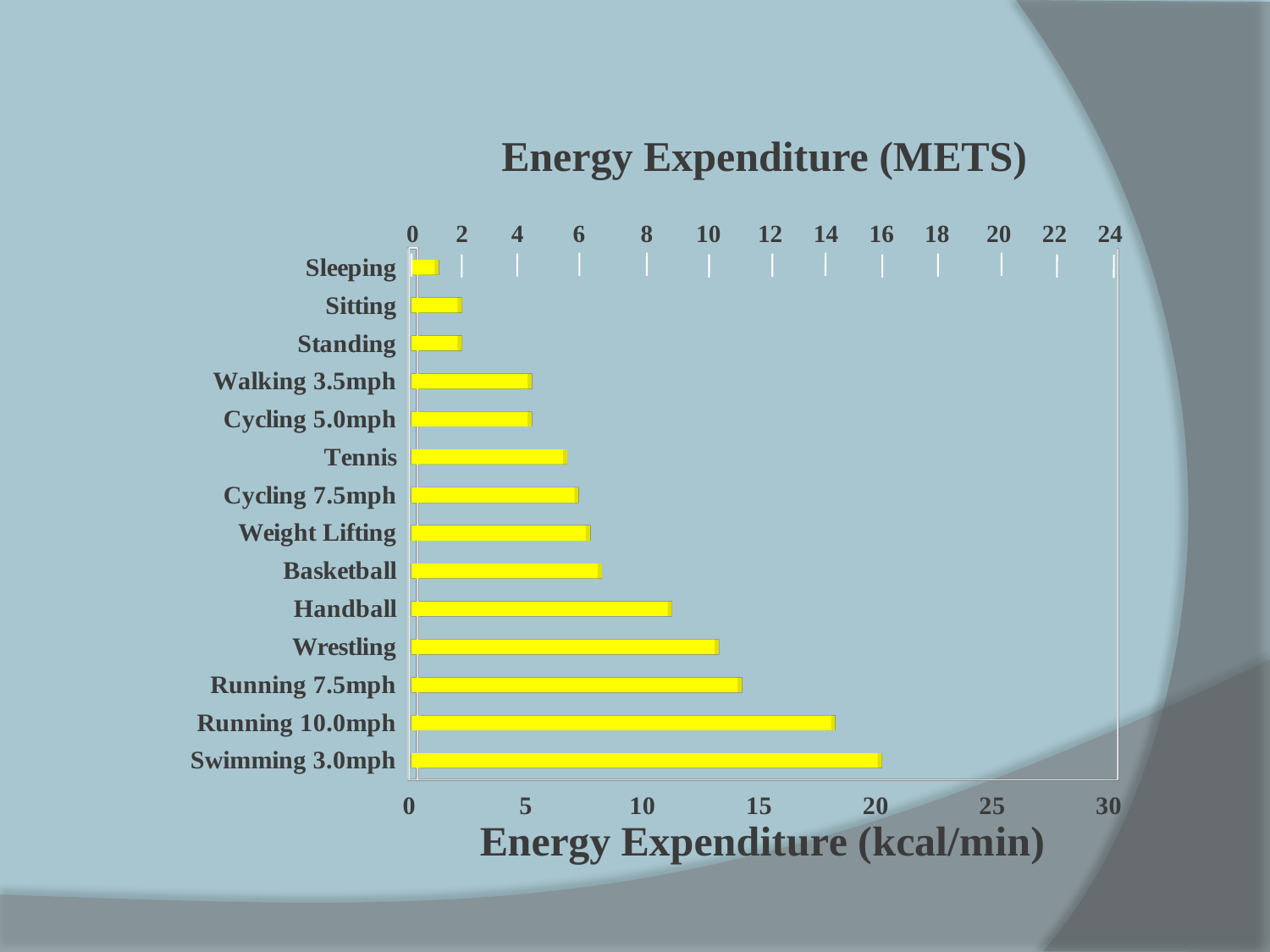
Which has a higher energy expenditure, Handball or Basketball? Handball What is the label of the bottom horizontal axis? Energy Expenditure (kcal/min) Is the value for Handball on the bottom axis greater or less than 10? greater Which activity has the highest energy expenditure? Swimming 3.0mph Is the value for Swimming 3.0mph on the bottom axis greater or less than 25? less What is the title of the chart? Energy Expenditure (METS) Is the value for Basketball on the bottom axis greater or less than 10? less Which has a higher energy expenditure, Running 10.0mph or Wrestling? Running 10.0mph Which activity has the lowest energy expenditure? Sleeping How many activities are plotted in the chart? 14 What kind of chart is shown on the slide? bar chart